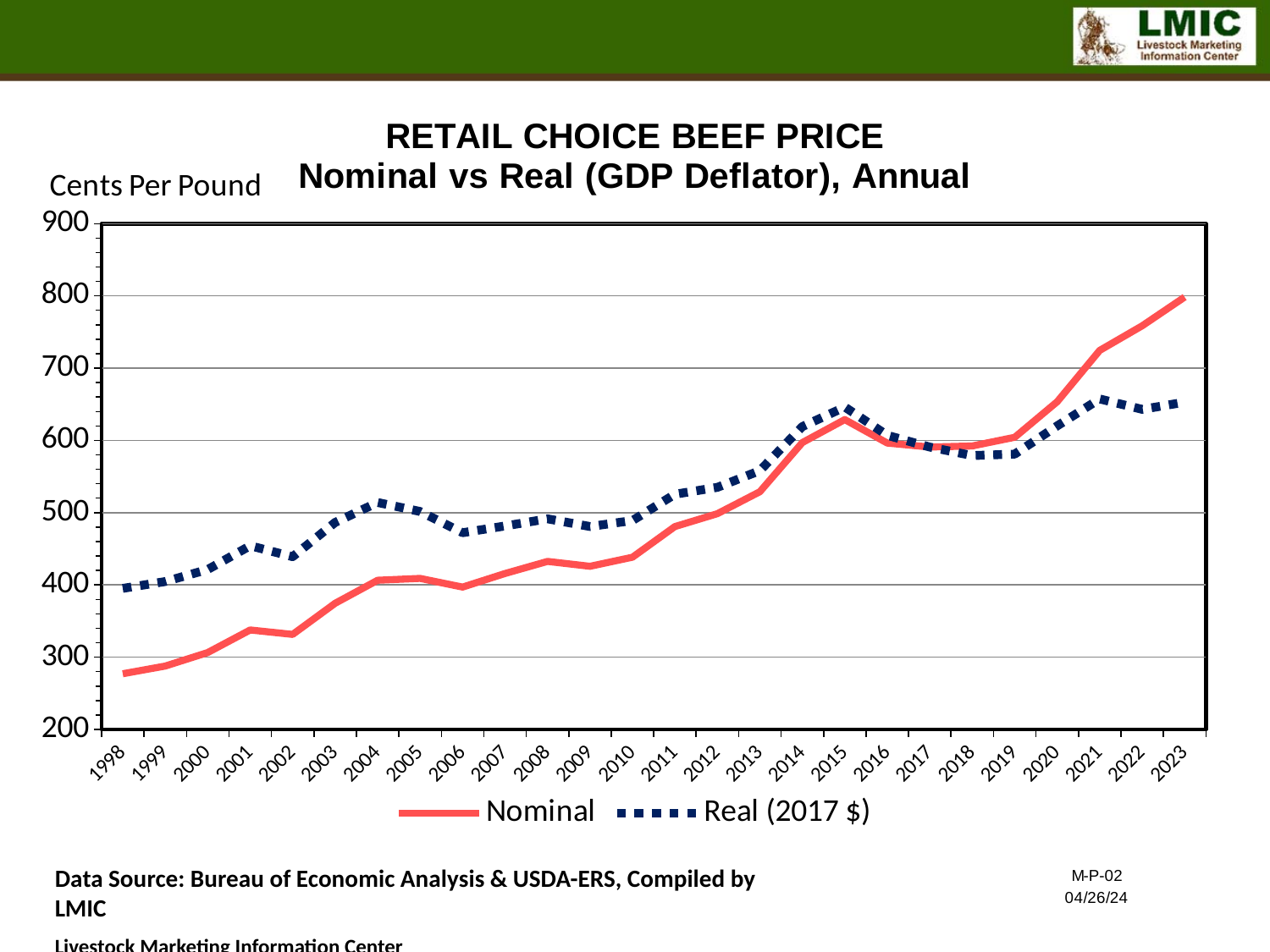
Does the Nominal price rise or fall from 2019 to 2023? Rise Is the Nominal value for 2023 greater or less than 700? greater Which series is drawn as a dashed line? Real (2017 $) In 2005, which series has the higher value, Nominal or Real (2017 $)? Real (2017 $) How many series does the legend list? 2 What kind of chart is shown on the slide? Line chart Is the Nominal value for 1998 greater or less than 300? less What is the unit shown on the y axis? Cents Per Pound Is the Real (2017 $) value for 2015 greater or less than 600? greater How many years are plotted along the x axis? 26 In which year is the Nominal price highest? 2023 In which year is the Nominal price lowest? 1998